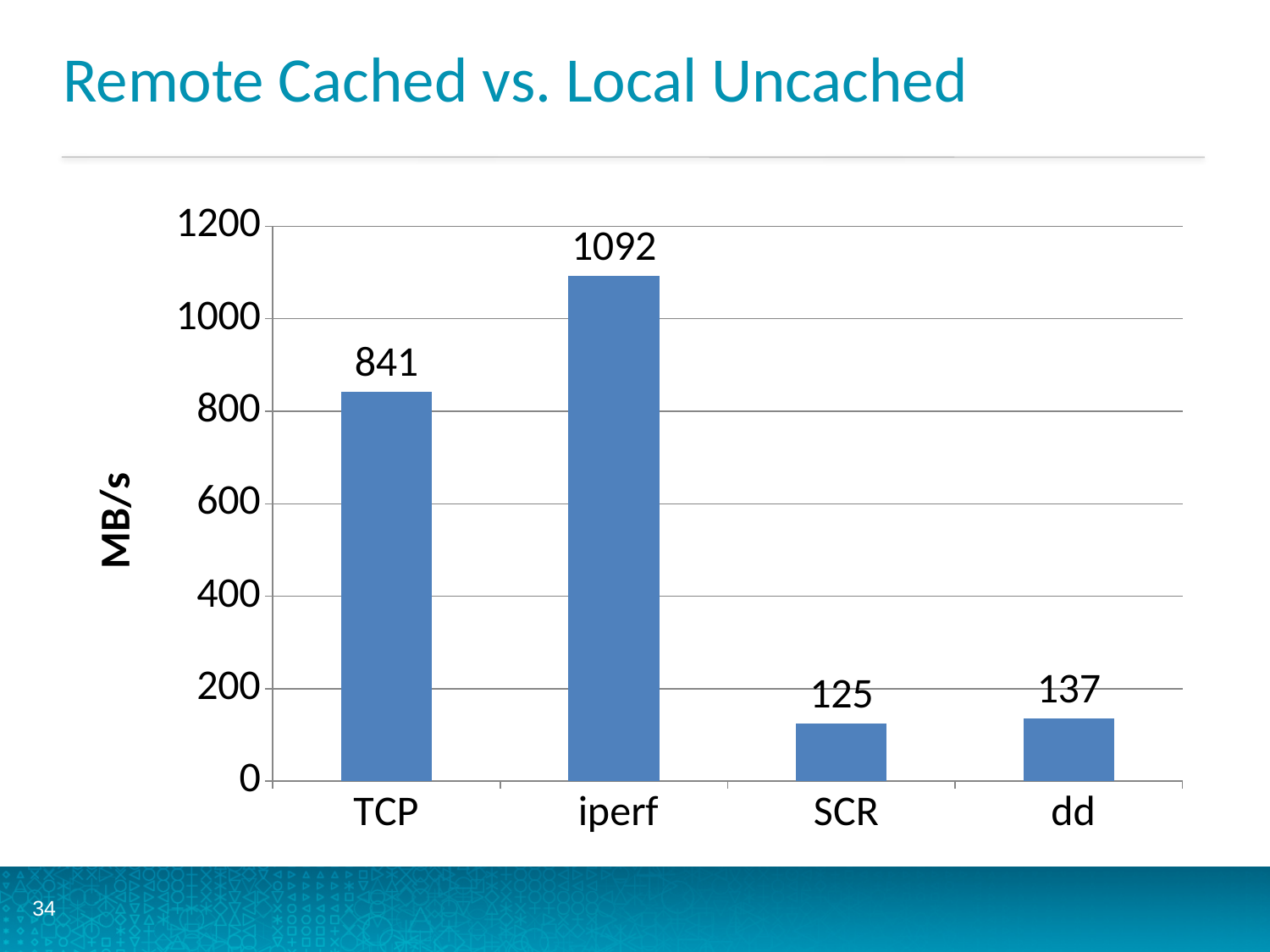
Which is larger, the value for TCP or the value for dd? TCP What kind of chart is shown on the slide? bar chart Which category has the lowest value? SCR What is the value for iperf? 1092 What is the difference between the values for iperf and TCP? 251 What is the difference between the values for dd and SCR? 12 Is the value for TCP greater or less than 800? greater What is the value for SCR? 125 How many categories are shown on the x axis? 4 What is the value for dd? 137 What is the value for TCP? 841 Which category has the highest value? iperf